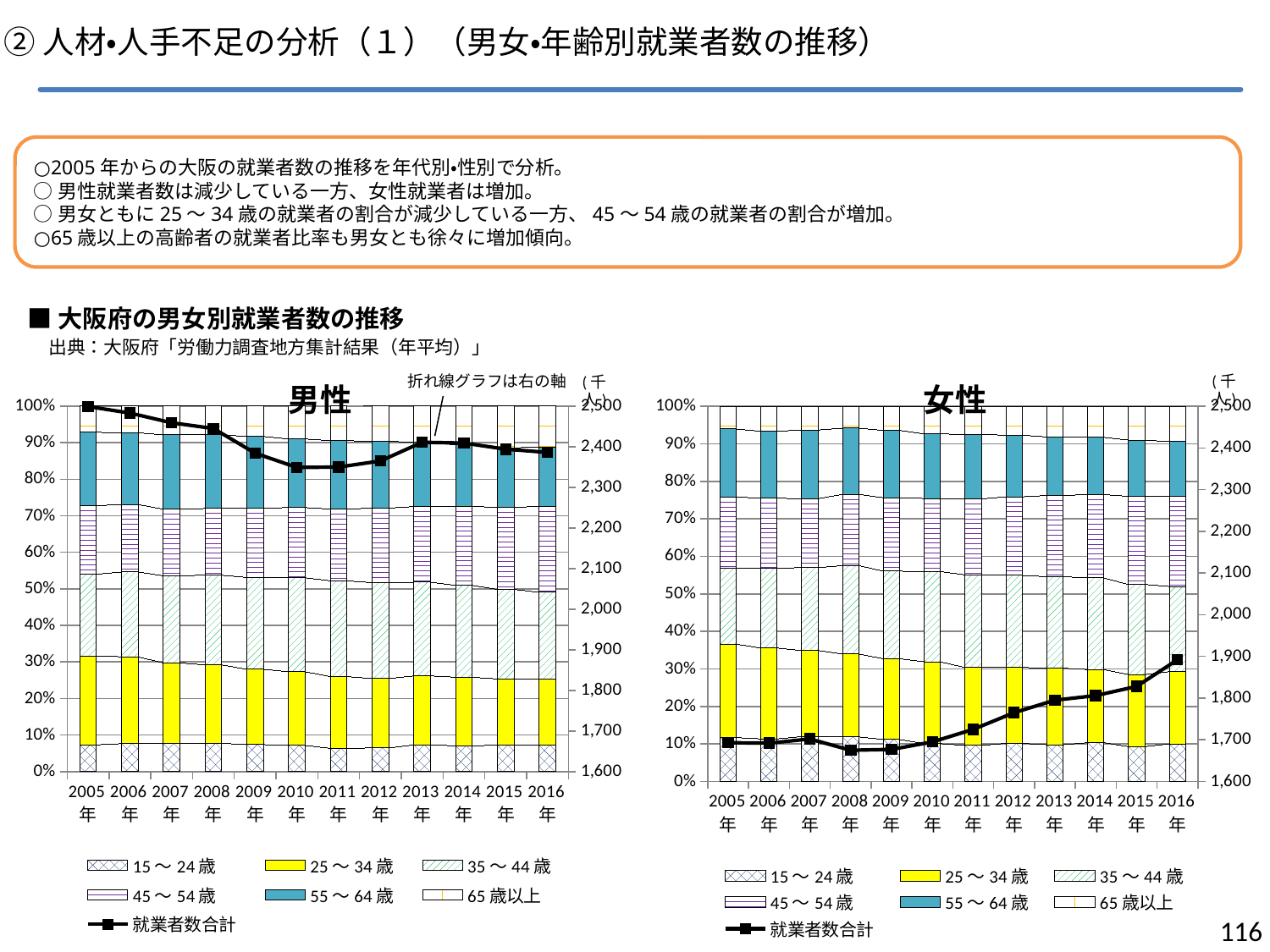
In the 女性 chart, does the 就業者数合計 line rise or fall from 2005 to 2016? rise In the 女性 chart, is the 就業者数合計 value for 2008 greater or less than 1,700? less In the 女性 chart, is the 就業者数合計 value for 2016 greater or less than 1,800? greater How many years are shown on the x axis of the 女性 chart? 12 In the 女性 chart, which year has the highest 就業者数合計 value? 2016年 In the 男性 chart, which year has the highest 就業者数合計 value? 2005年 In the 男性 chart, is the 就業者数合計 value for 2010 greater or less than 2,400? less In the 男性 chart, which is larger, the 就業者数合計 value for 2005 or for 2016? 2005 What is the title of the chart on the right side of the slide? 女性 What kind of chart is the 男性 chart? stacked bar chart with a line In the 男性 chart, does the 就業者数合計 line rise or fall from 2005 to 2016? fall How many series does the legend of the 男性 chart list? 7